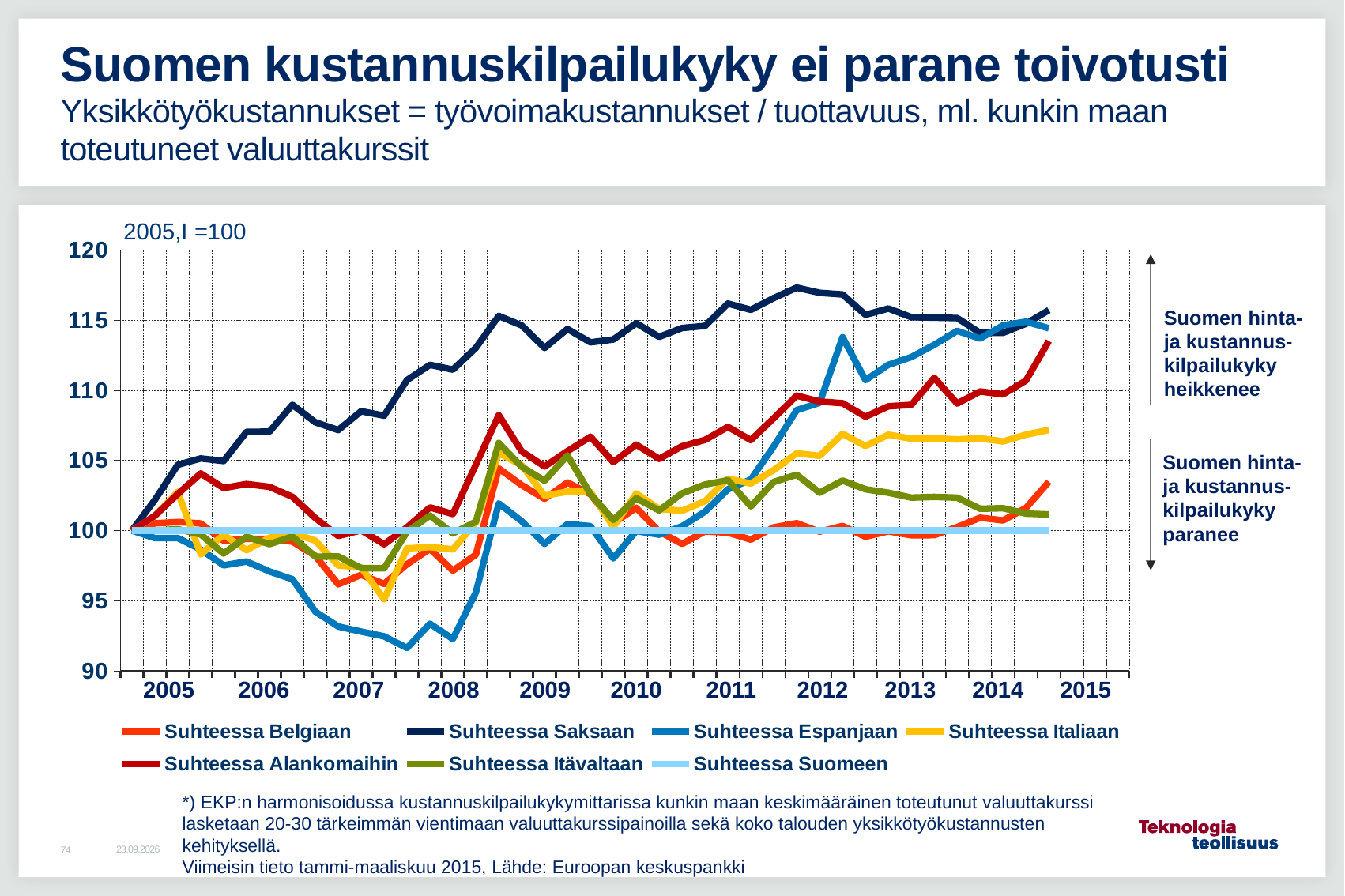
What kind of chart is shown on the slide? line chart Which series falls to the lowest value anywhere on the chart? Suhteessa Espanjaan How many series does the legend list? 7 Is the value for Suhteessa Saksaan at the end of 2014 greater or less than 110? greater Which series reaches the highest value anywhere on the chart? Suhteessa Saksaan Is the value for Suhteessa Espanjaan in 2007 greater or less than 95? less Is the value for Suhteessa Italiaan at the end of the series greater or less than 105? greater How many year labels are shown on the x axis? 11 Which series stays flat at 100 across the whole chart? Suhteessa Suomeen What base period and index value is stated above the chart? 2005,I =100 At the end of the series, which is larger: Suhteessa Saksaan or Suhteessa Belgiaan? Suhteessa Saksaan Does the Suhteessa Saksaan series rise or fall between 2005 and 2009? rises